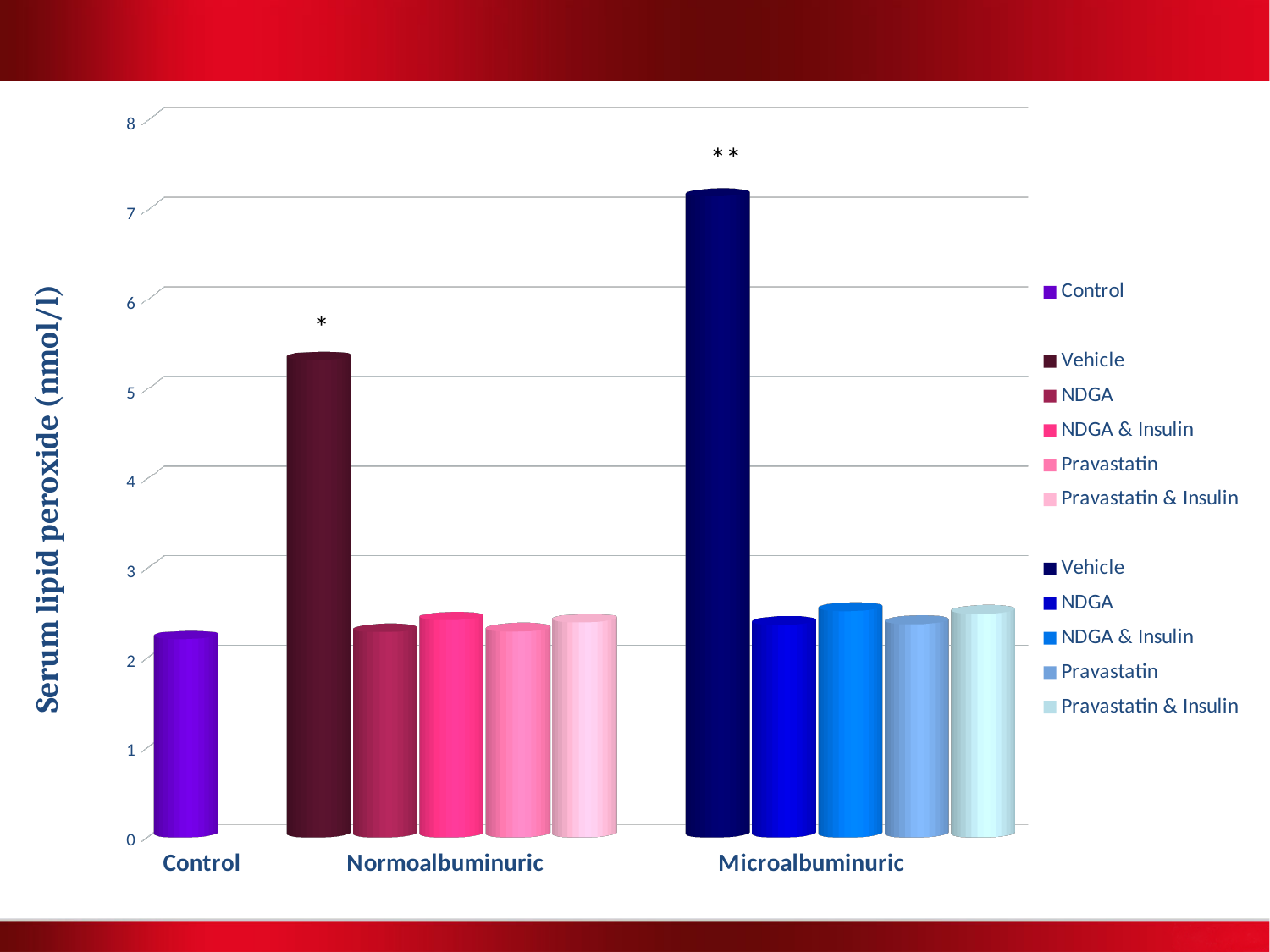
Is the value for NDGA & Insulin in the Normoalbuminuric group greater or less than 3? less Which bar is the tallest in the chart? Vehicle in the Microalbuminuric group Is the value for Vehicle in the Normoalbuminuric group greater or less than 5? greater What kind of chart is shown on the slide? bar chart Which bar is marked with two asterisks (**)? Vehicle in the Microalbuminuric group Is the value for Vehicle in the Microalbuminuric group greater or less than 6? greater What is the title of the y axis? Serum lipid peroxide (nmol/l) Which is larger: the Vehicle bar in the Microalbuminuric group or the Vehicle bar in the Normoalbuminuric group? Vehicle in the Microalbuminuric group Within the Normoalbuminuric group, which is larger: Vehicle or NDGA? Vehicle How many entries does the legend list? 11 How many groups are labelled along the x axis? 3